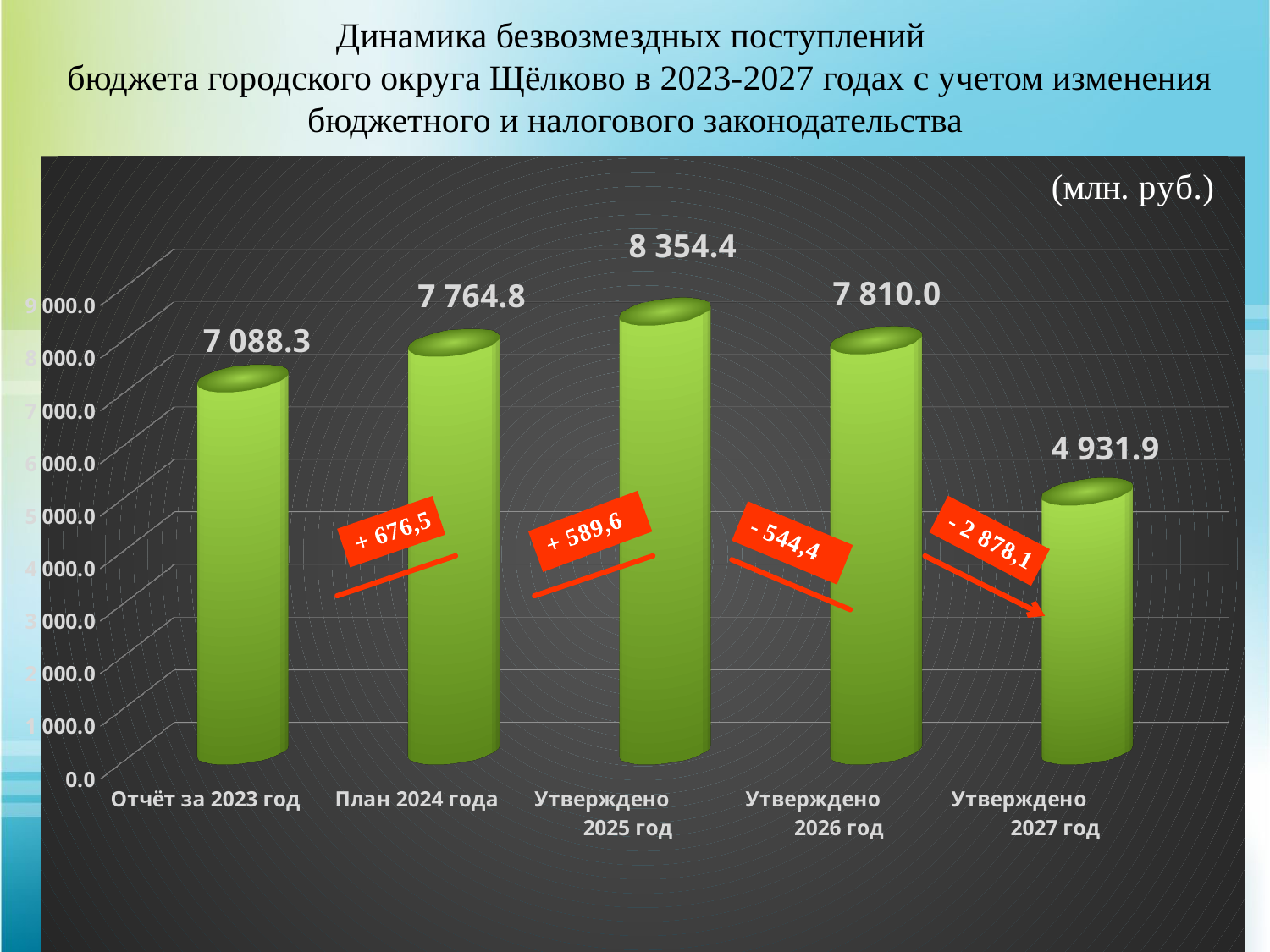
What is the value for План 2024 года? 7 764.8 What kind of chart is shown on the slide? Bar chart Which category has the highest value? Утверждено 2025 год What is the difference between the values for Утверждено 2026 год and Утверждено 2027 год? 2 878.1 Which is larger, the value for План 2024 года or the value for Утверждено 2026 год? Утверждено 2026 год How many categories are shown on the x axis? 5 What is the difference between the values for План 2024 года and Отчёт за 2023 год? 676.5 What is the value for Отчёт за 2023 год? 7 088.3 What is the value for Утверждено 2025 год? 8 354.4 Do the values rise or fall from Утверждено 2025 год to Утверждено 2027 год? Fall Which category has the lowest value? Утверждено 2027 год What is the value for Утверждено 2027 год? 4 931.9